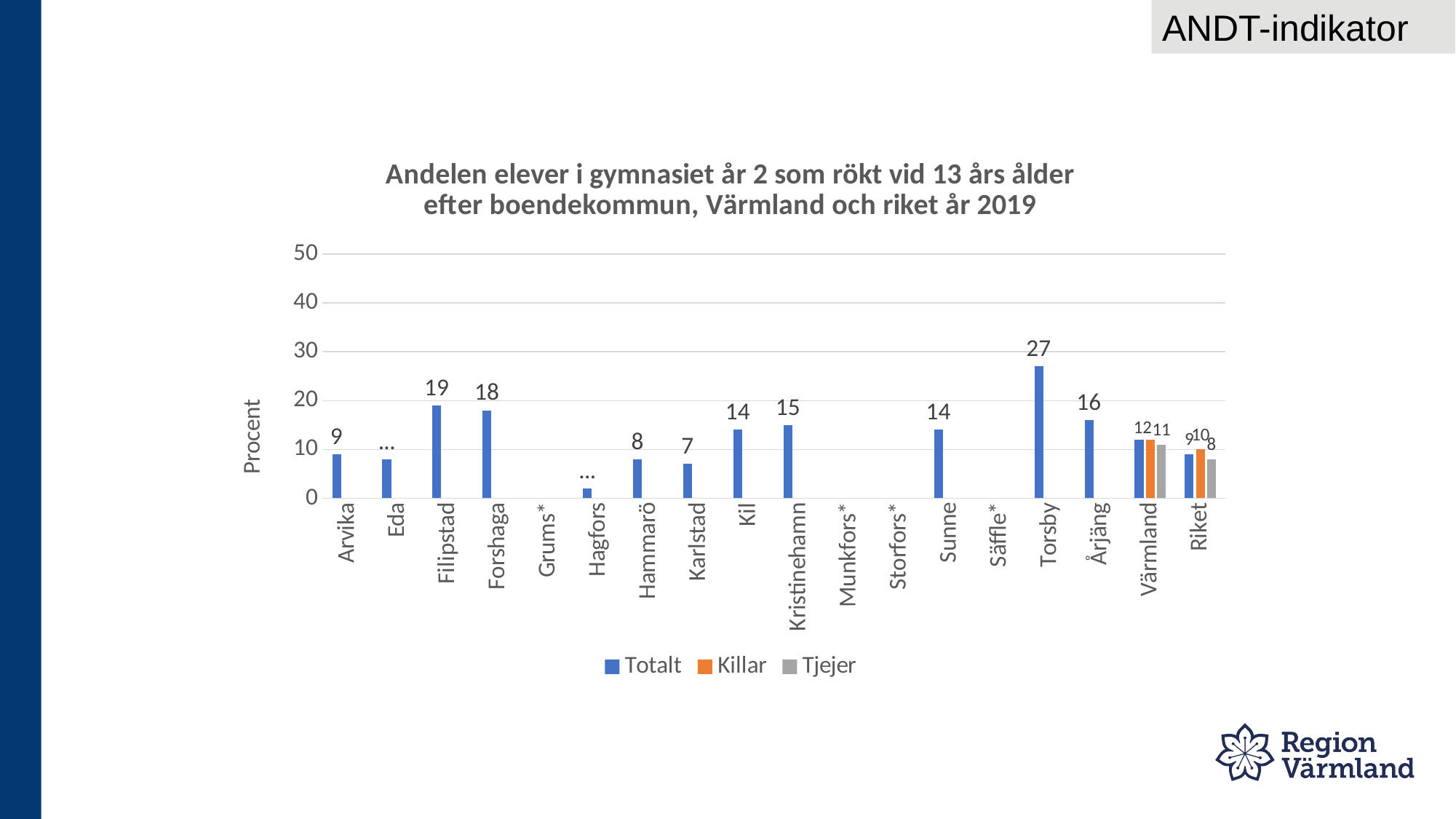
What is the label on the y axis? Procent What is the Totalt value for Torsby? 27 What kind of chart is shown on the slide? Bar chart Which municipality has the highest Totalt value? Torsby What is the Tjejer value for Värmland? 11 Which has a higher Totalt value, Kil or Karlstad? Kil What is the Killar value for Riket? 10 How many series does the legend list? 3 What is the Totalt value for Filipstad? 19 What is the difference between the Totalt values for Filipstad and Forshaga? 1 How many categories are shown on the x axis? 18 Is the Totalt value for Hagfors greater or less than 10? less